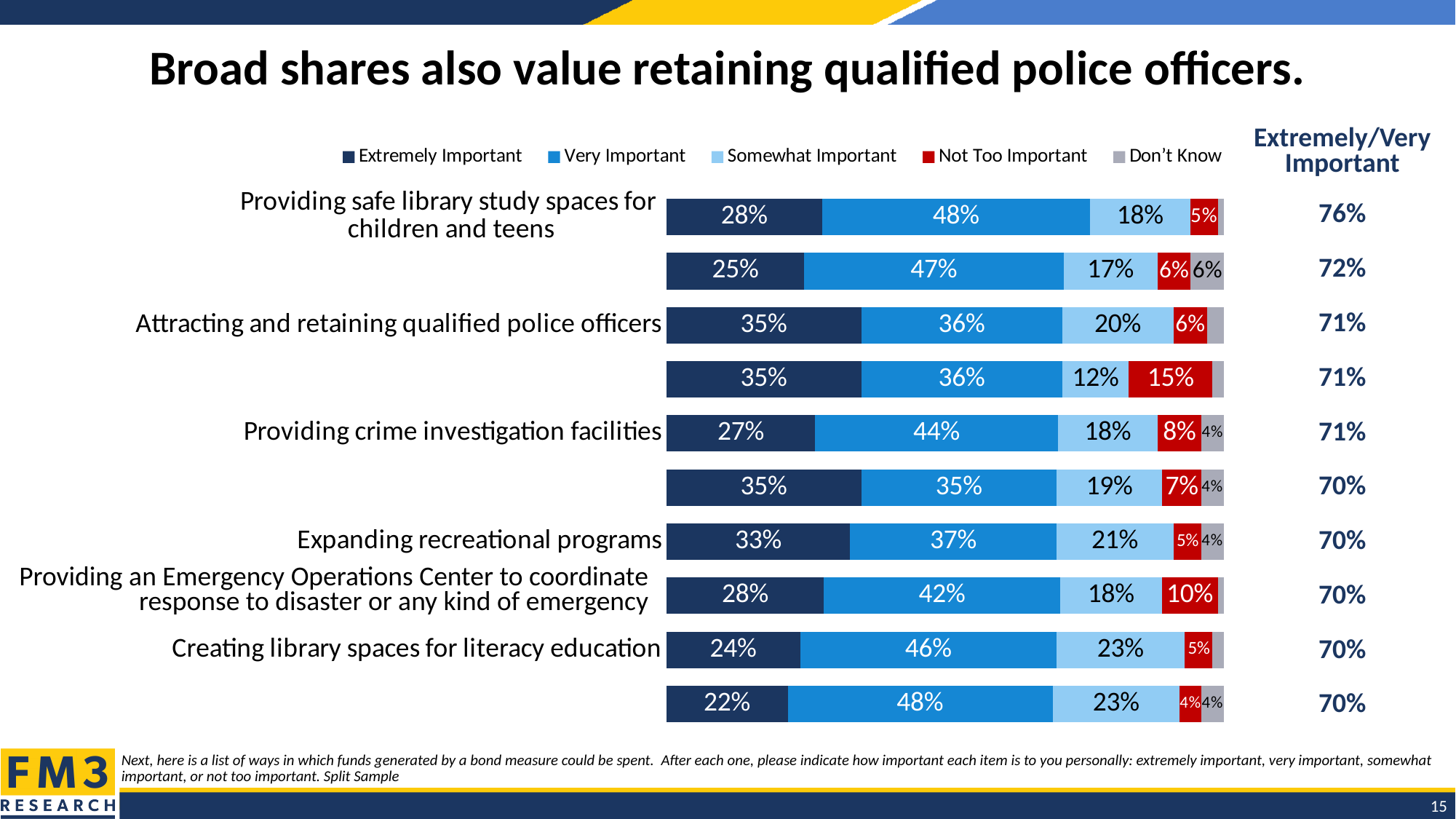
How many series does the chart legend list? 5 What is the title of the slide? Broad shares also value retaining qualified police officers. For 'Providing crime investigation facilities', how many percentage points higher is the Very Important share than the Extremely Important share? 17 percentage points How many percentage points higher is the Somewhat Important share for 'Creating library spaces for literacy education' than for 'Providing crime investigation facilities'? 5 percentage points Which item has the highest Extremely/Very Important total? Providing safe library study spaces for children and teens What is the Extremely/Very Important total for 'Expanding recreational programs'? 70% What share rated 'Providing safe library study spaces for children and teens' as Very Important? 48% What share rated 'Providing an Emergency Operations Center to coordinate response to disaster or any kind of emergency' as Not Too Important? 10% What kind of chart is shown on the slide? Stacked bar chart Which has a larger Extremely Important share: 'Attracting and retaining qualified police officers' or 'Providing safe library study spaces for children and teens'? Attracting and retaining qualified police officers What share rated 'Creating library spaces for literacy education' as Somewhat Important? 23% What share rated 'Attracting and retaining qualified police officers' as Extremely Important? 35%